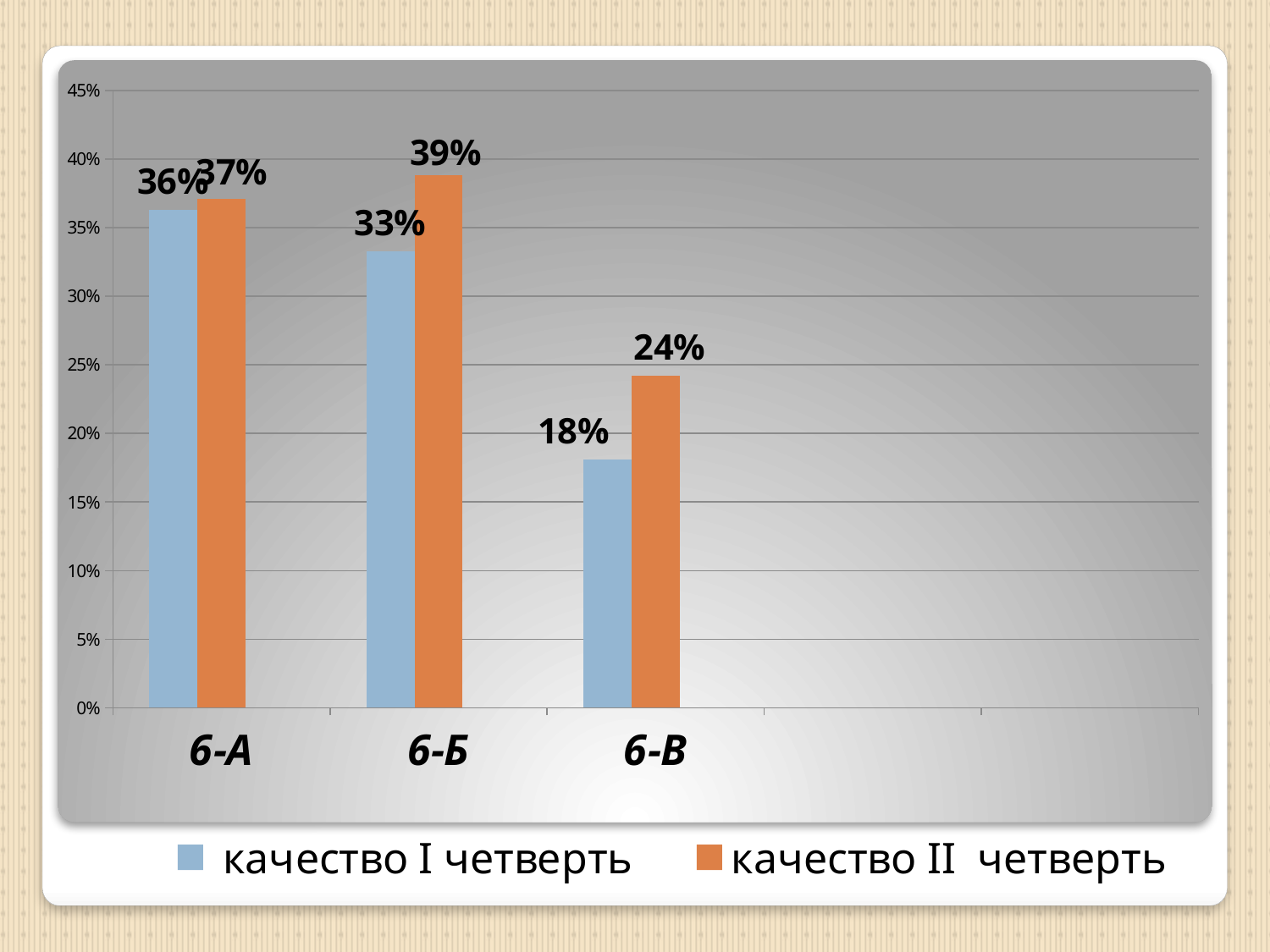
What kind of chart is shown on the slide? bar chart What is the value for 6-Б in the качество II четверть series? 39% What is the difference between the качество II четверть and качество I четверть values for 6-В? 6% What is the difference between the качество II четверть and качество I четверть values for 6-Б? 6% What is the value for 6-А in the качество I четверть series? 36% What is the value for 6-В in the качество I четверть series? 18% Which class has the lowest value in the качество I четверть series? 6-В What is the value for 6-В in the качество II четверть series? 24% How many classes are shown on the x axis? 3 Which class has the highest value in the качество II четверть series? 6-Б Which is larger for 6-Б: качество I четверть or качество II четверть? качество II четверть How many series does the legend list? 2